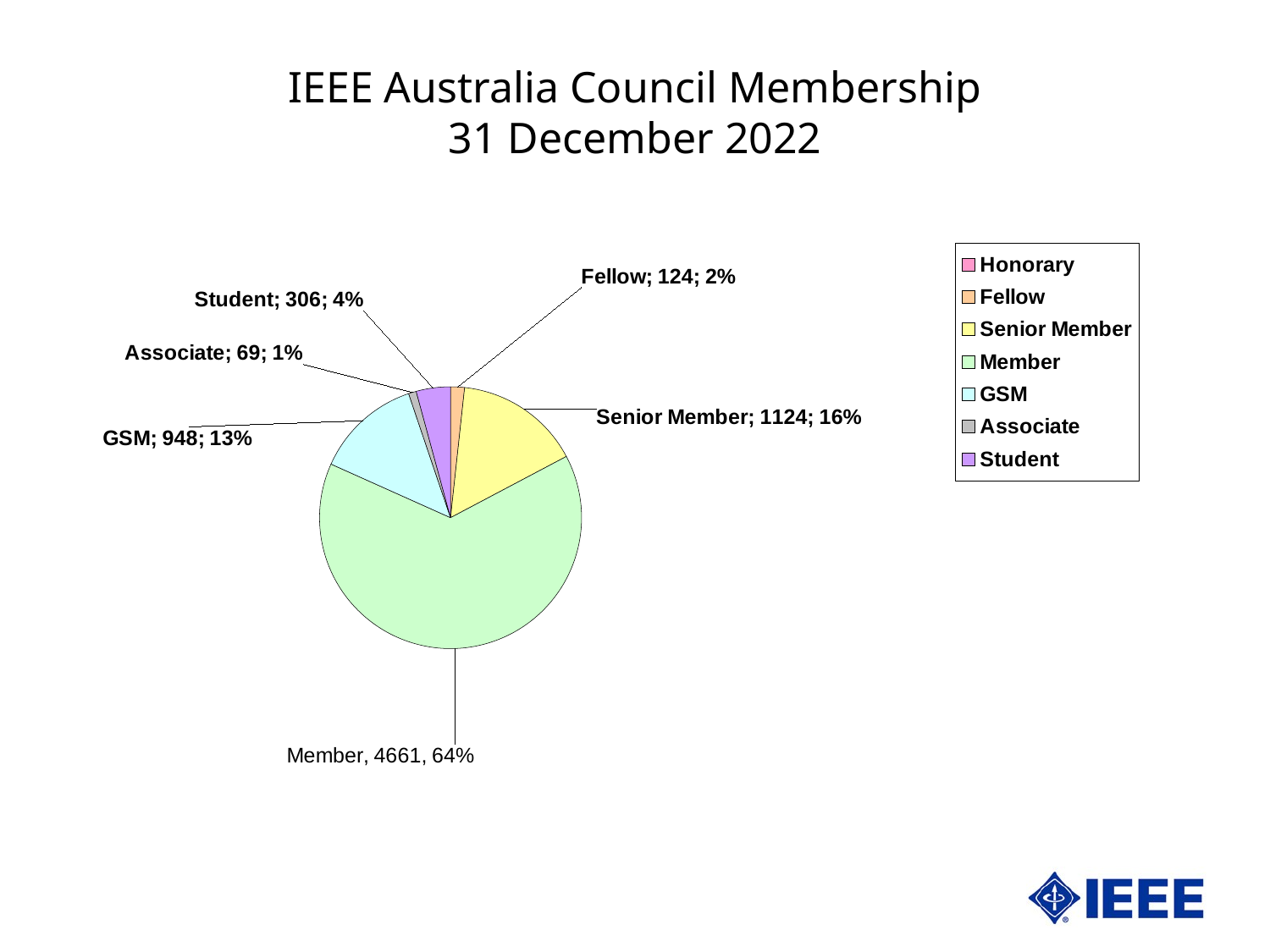
What share of the pie does the Student slice represent? 4% What share of the pie does the Fellow slice represent? 2% Which is larger, the Fellow count or the Student count? Student How many members are in the Member category? 4661 Which labelled membership category has the smallest slice of the pie? Associate What type of chart is shown on the slide? pie chart What share of the pie does the Senior Member slice represent? 16% How many members are in the GSM category? 948 How many entries does the legend list? 7 Which membership category has the largest slice of the pie? Member What is the difference between the Senior Member count and the GSM count? 176 What is the title of the chart on the slide? IEEE Australia Council Membership 31 December 2022